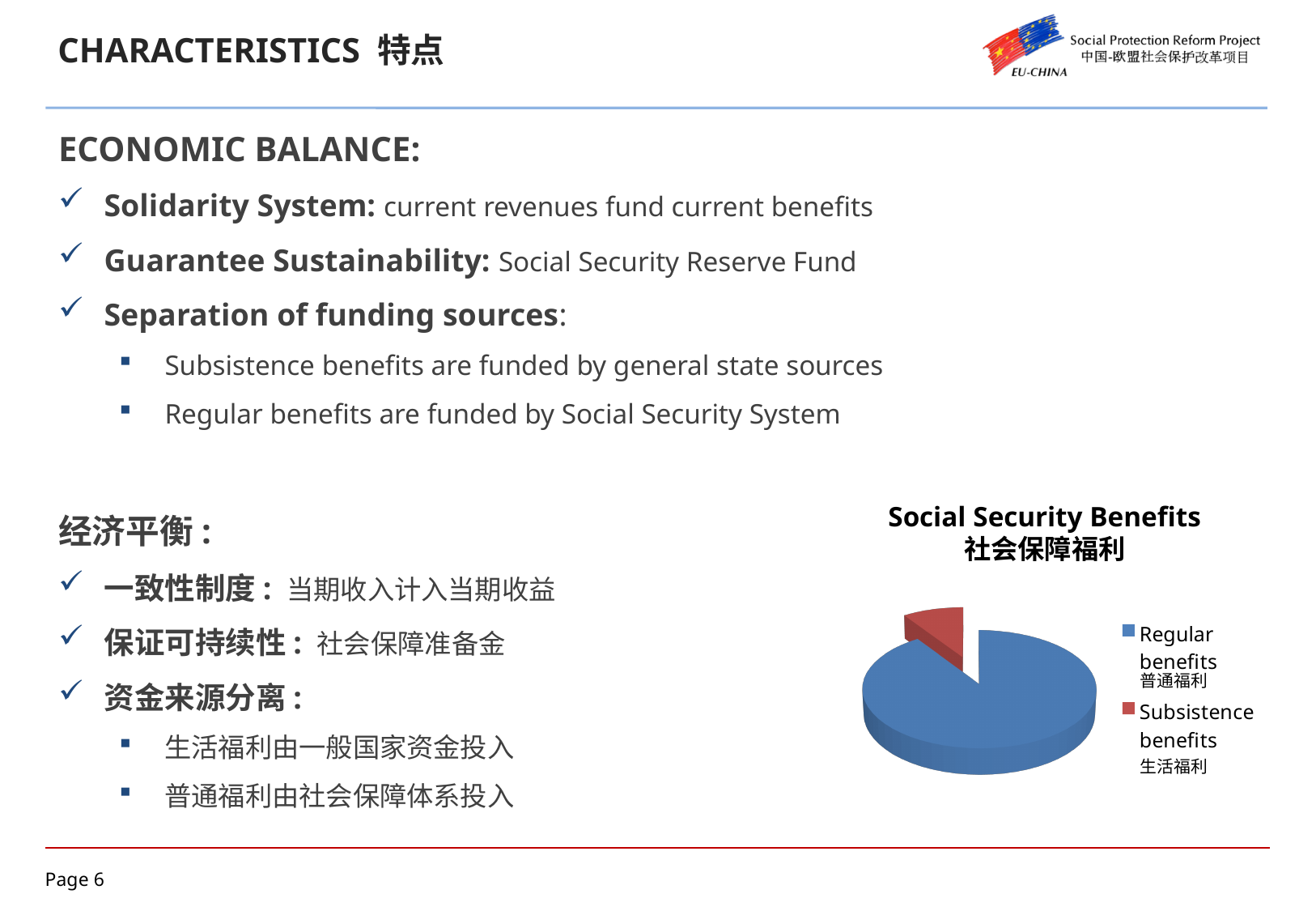
What colour is the Subsistence benefits slice in the pie chart? red Which category has the largest slice in the pie chart? Regular benefits How many slices does the pie chart have? 2 What kind of chart is shown on the slide? pie chart What is the title of the chart on the slide? Social Security Benefits 社会保障福利 Which slice is larger, Regular benefits or Subsistence benefits? Regular benefits How many entries does the chart legend list? 2 Which category has the smallest slice in the pie chart? Subsistence benefits